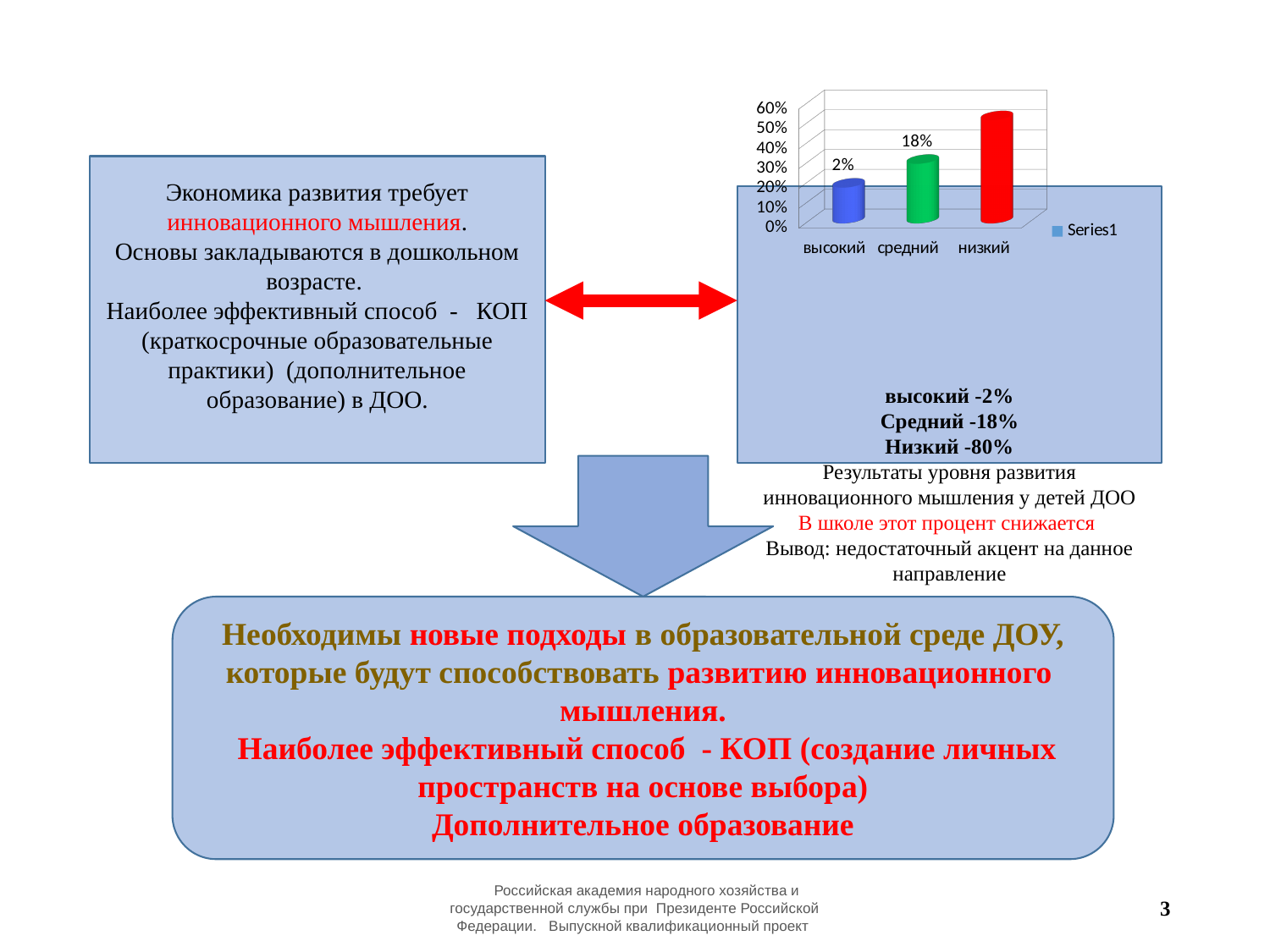
How many series does the chart legend list? 1 Which is larger, the value for средний or the value for высокий? средний Is the value for низкий greater or less than 40%? greater What is the difference between the values for средний and высокий? 16% Do the bar values rise or fall from left to right along the x axis? rise How many categories are shown on the x axis of the chart? 3 What kind of chart is shown on the slide? bar chart Which category has the highest bar in the chart? низкий Which category has the lowest bar in the chart? высокий What is the value for высокий in the chart? 2% What is the value for средний in the chart? 18%